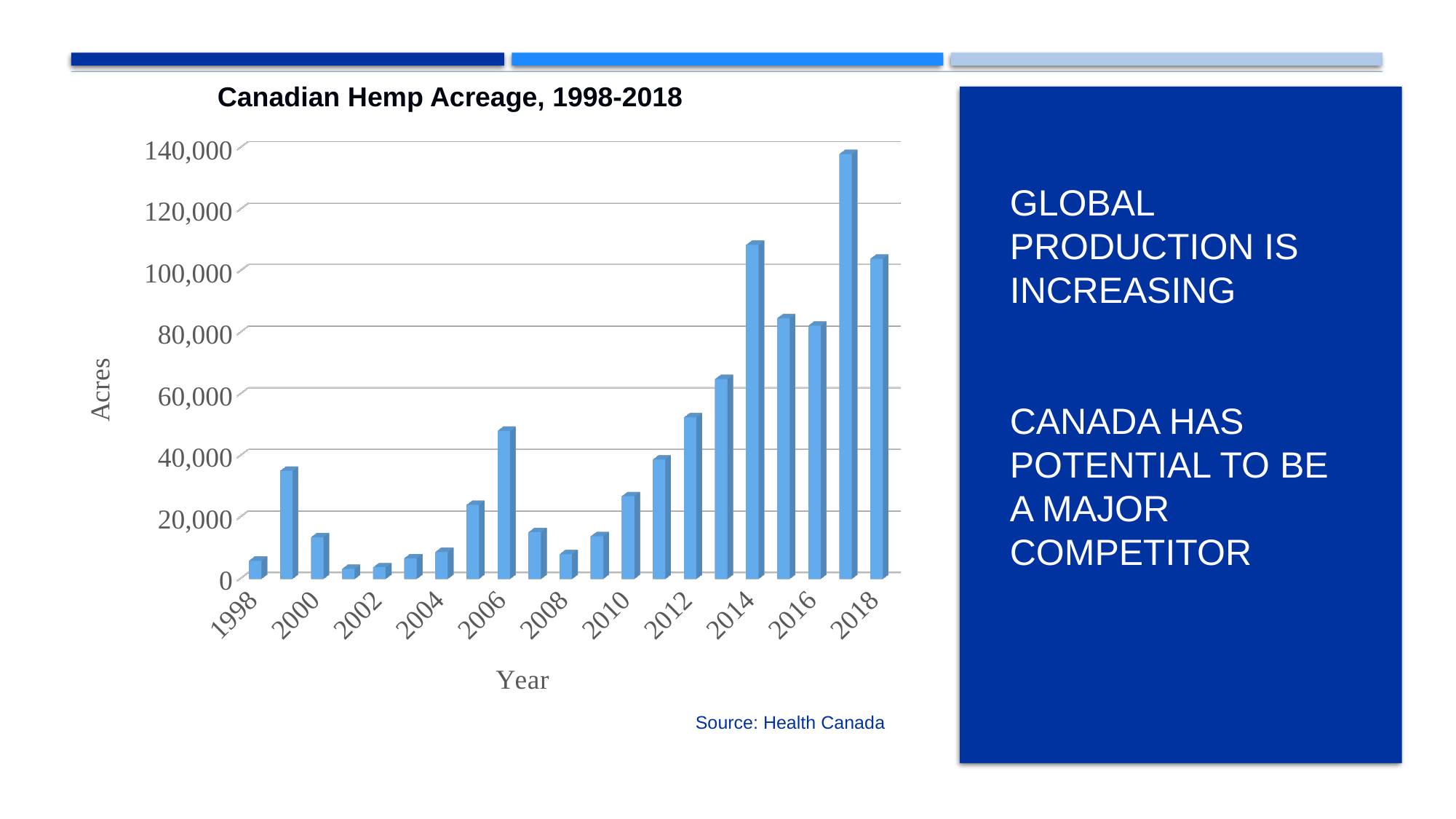
What is the title of the chart? Canadian Hemp Acreage, 1998-2018 Is the value for 2000 greater or less than 20,000? less What is the label on the vertical axis of the chart? Acres Is the value for 2006 greater or less than 40,000? greater Which year has the larger hemp acreage, 2006 or 2012? 2012 Is the value for 2016 greater or less than 100,000? less Which year has the larger hemp acreage, 2014 or 2017? 2017 What kind of chart is shown on the slide? bar chart How many bars (years) are plotted in the chart? 21 Which year has the highest hemp acreage in the chart? 2017